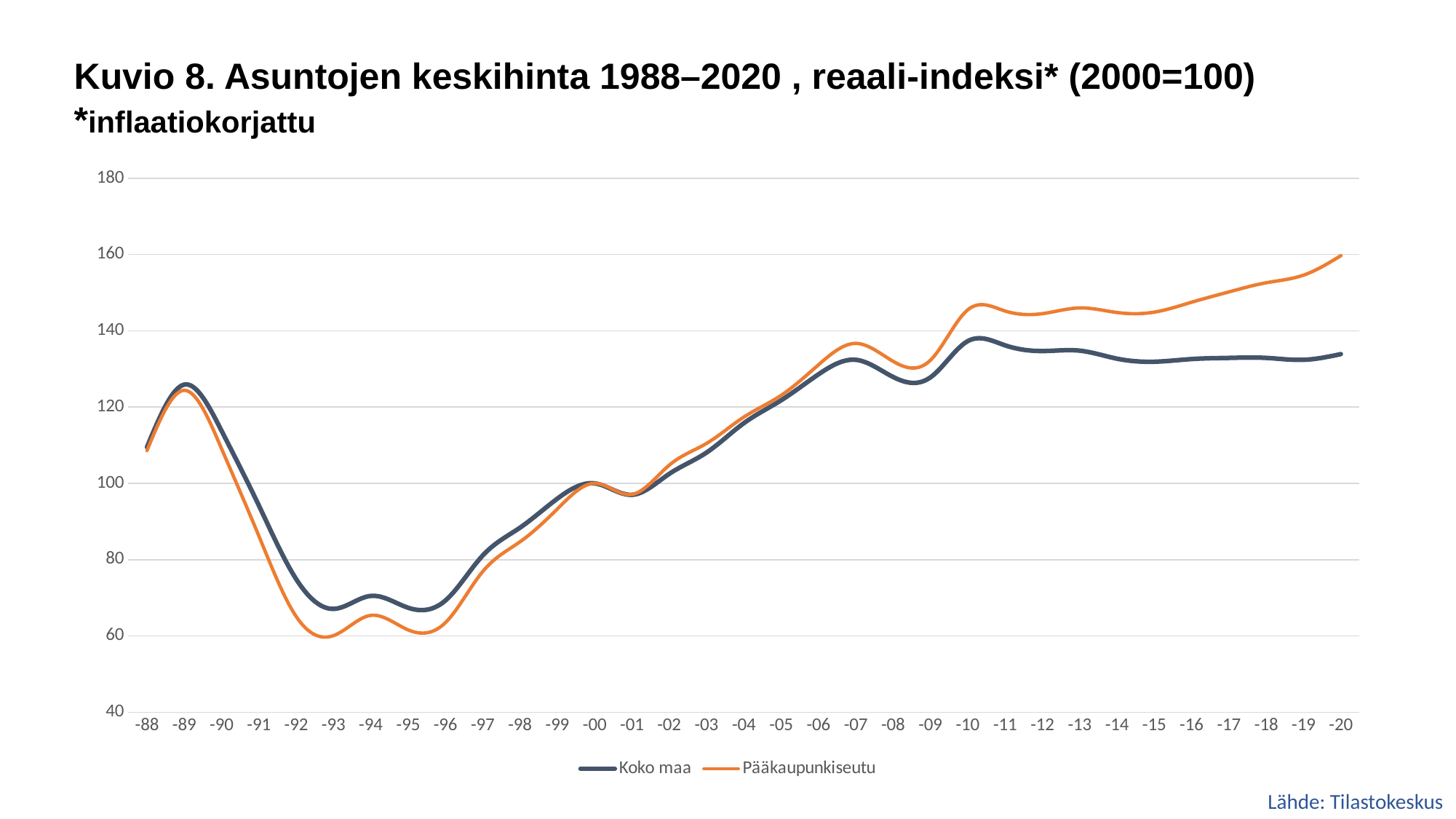
What kind of chart is shown on the slide? line chart In which year does the Pääkaupunkiseutu series reach its lowest value? -93 Is the value for Koko maa in -93 greater or less than 80? less What is the value of the Pääkaupunkiseutu series in -00? 100 How many years are shown on the x axis? 33 Is the value for Pääkaupunkiseutu in -20 greater or less than 140? greater In which year does the Pääkaupunkiseutu series reach its highest value? -20 Which series has the higher value in -20, Koko maa or Pääkaupunkiseutu? Pääkaupunkiseutu How many series does the legend list? 2 Which series is drawn in orange? Pääkaupunkiseutu What is the value of the Koko maa series in -00? 100 Do the values of the Pääkaupunkiseutu series rise or fall between -10 and -20? rise